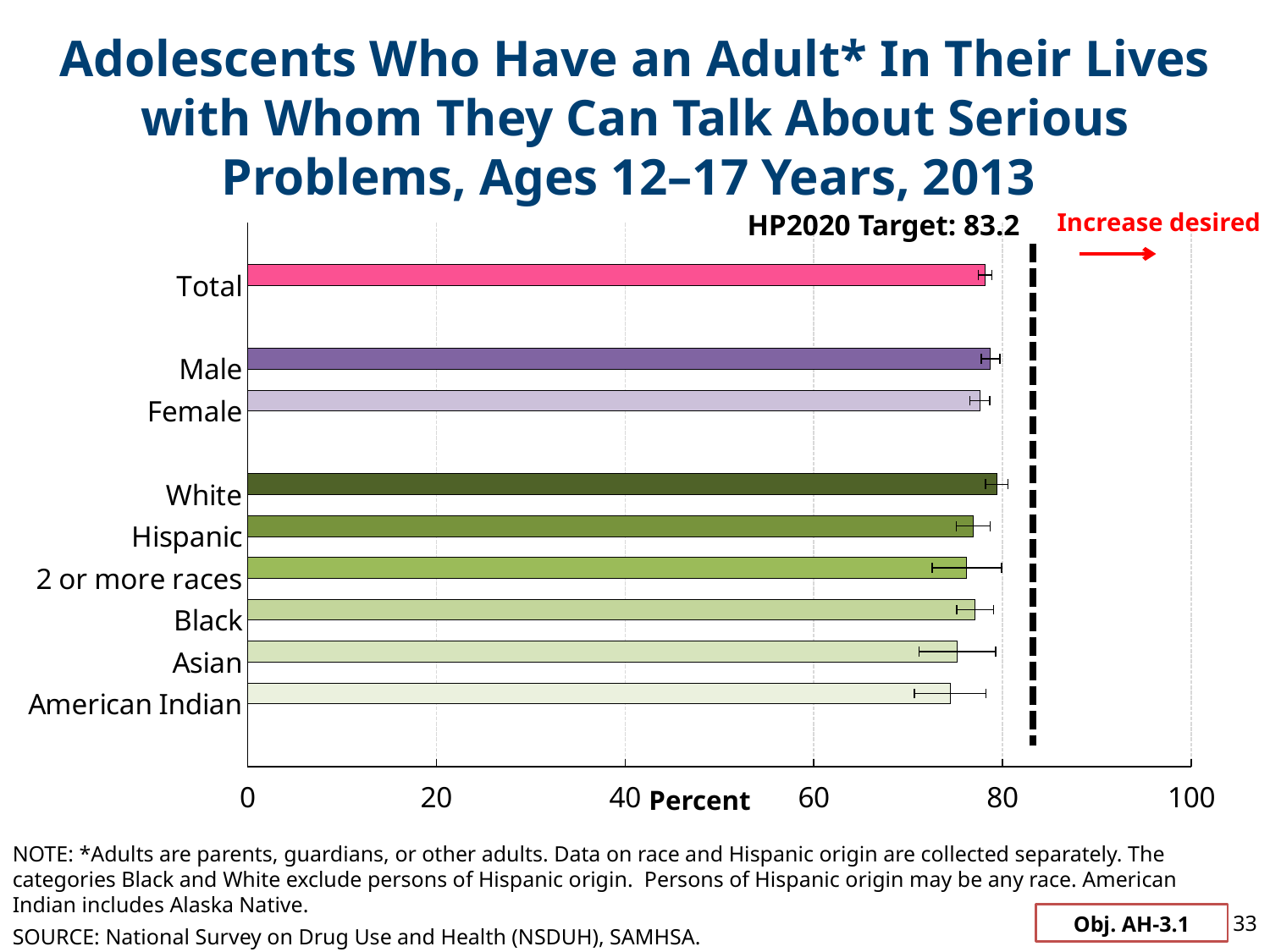
How many categories (bars) are plotted in the chart? 9 Is the value for Total greater or less than 80? less Which category has the lowest value? American Indian Which category has the highest value? White Which is larger, the value for White or the value for American Indian? White Is the value for American Indian greater or less than 60? greater What is the label of the x axis? Percent Which is larger, the value for Male or the value for Asian? Male What kind of chart is shown on the slide? bar chart Is the value for Asian greater or less than 80? less What is the HP2020 Target value shown on the chart? 83.2